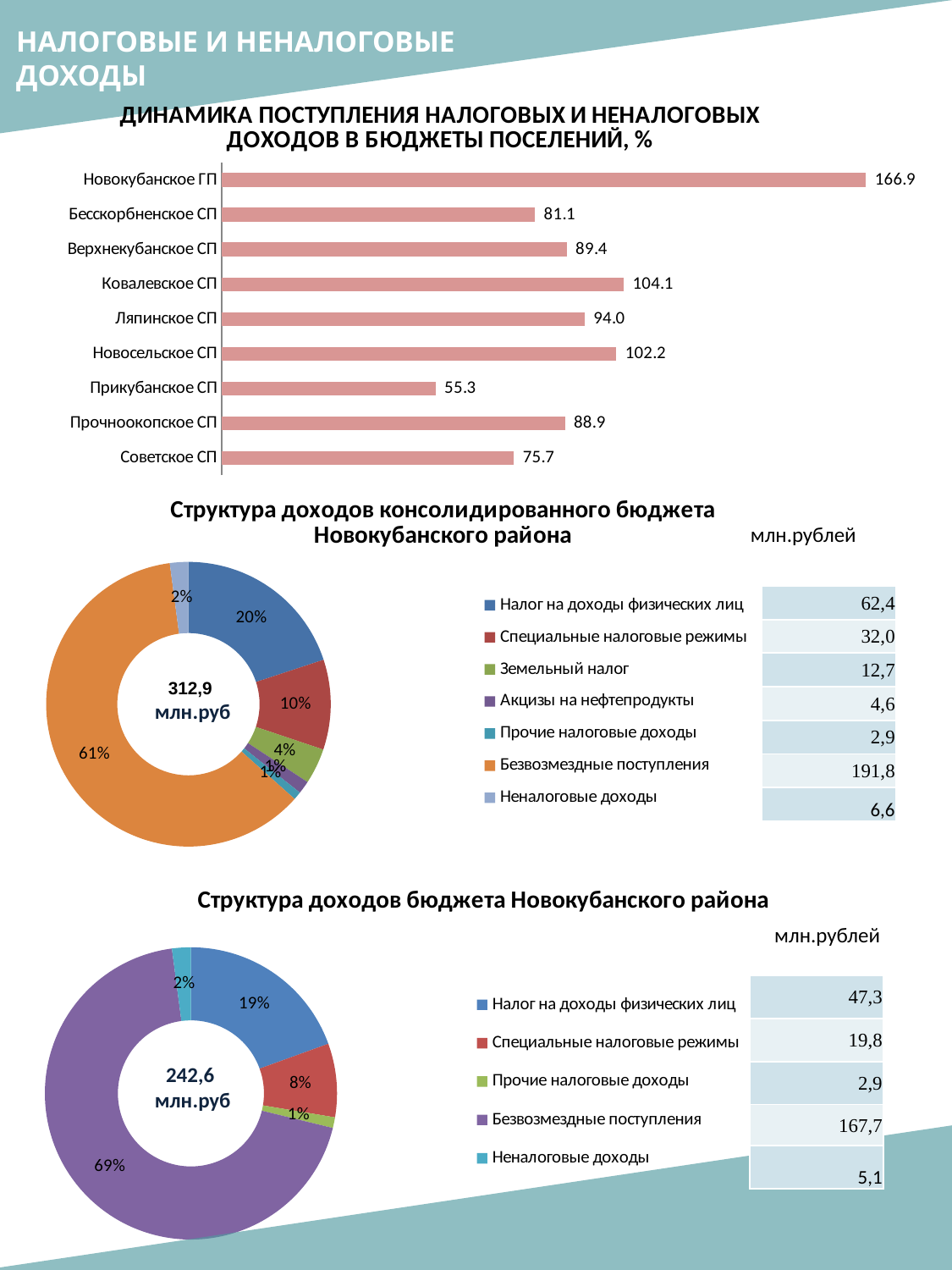
In the bar chart 'Динамика поступления налоговых и неналоговых доходов в бюджеты поселений, %', which is larger: Бесскорбненское СП or Советское СП? Бесскорбненское СП In the chart 'Структура доходов консолидированного бюджета Новокубанского района', what share of the total is Безвозмездные поступления? 61% In the bar chart 'Динамика поступления налоговых и неналоговых доходов в бюджеты поселений, %', which settlement has the lowest value? Прикубанское СП What total is shown in the centre of the donut chart 'Структура доходов бюджета Новокубанского района'? 242,6 млн.руб How many categories does the legend list in the chart 'Структура доходов консолидированного бюджета Новокубанского района'? 7 In the chart 'Структура доходов консолидированного бюджета Новокубанского района', what is the value for Налог на доходы физических лиц in млн.рублей? 62,4 In the bar chart 'Динамика поступления налоговых и неналоговых доходов в бюджеты поселений, %', what is the value for Новокубанское ГП? 166.9 In the bar chart 'Динамика поступления налоговых и неналоговых доходов в бюджеты поселений, %', what is the difference between Ковалевское СП and Новосельское СП? 1.9 How many settlements are shown in the bar chart 'Динамика поступления налоговых и неналоговых доходов в бюджеты поселений, %'? 9 In the bar chart 'Динамика поступления налоговых и неналоговых доходов в бюджеты поселений, %', which settlement has the highest value? Новокубанское ГП What type of chart is 'Динамика поступления налоговых и неналоговых доходов в бюджеты поселений, %'? Bar chart In the chart 'Структура доходов бюджета Новокубанского района', what is the value for Безвозмездные поступления in млн.рублей? 167,7